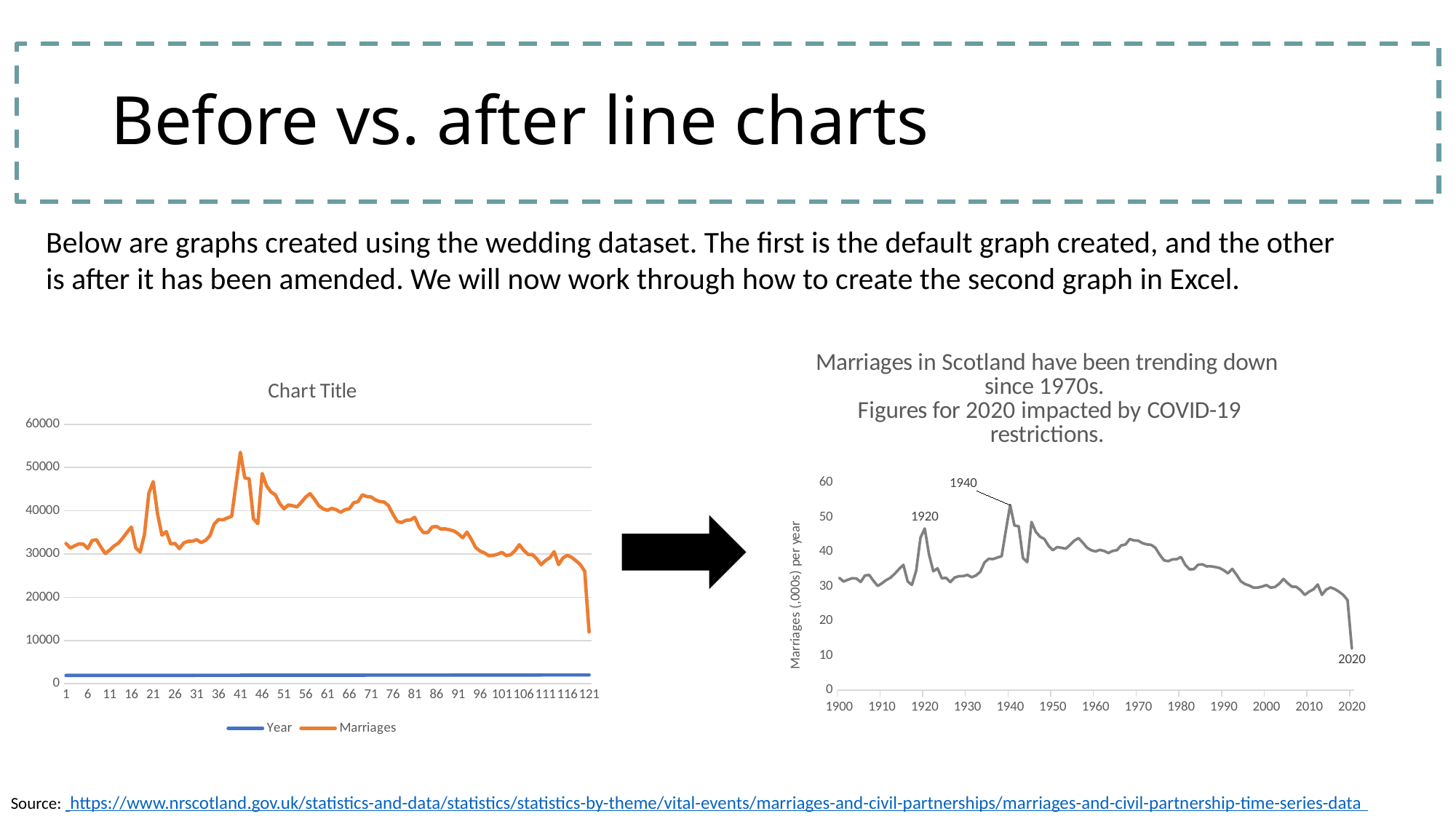
What kind of chart is the chart on the right about marriages in Scotland? line chart In the right chart about marriages in Scotland, do the values rise or fall between 1970 and 2020? fall How many series does the legend of the left chart ('Chart Title') list? 2 In the right chart about marriages in Scotland, which labelled year has the highest value? 1940 In the left chart ('Chart Title'), is the Marriages value at point 121 greater or less than 20000? less In the right chart about marriages in Scotland, is the value for 2020 greater or less than 20? less What kind of chart is the chart on the left titled 'Chart Title'? line chart In the left chart ('Chart Title'), which series is drawn in orange? Marriages What are the two series named in the legend of the left chart ('Chart Title')? Year and Marriages In the right chart about marriages in Scotland, which labelled year has the lowest value? 2020 In the left chart ('Chart Title'), is the Marriages value at point 41 greater or less than 40000? greater